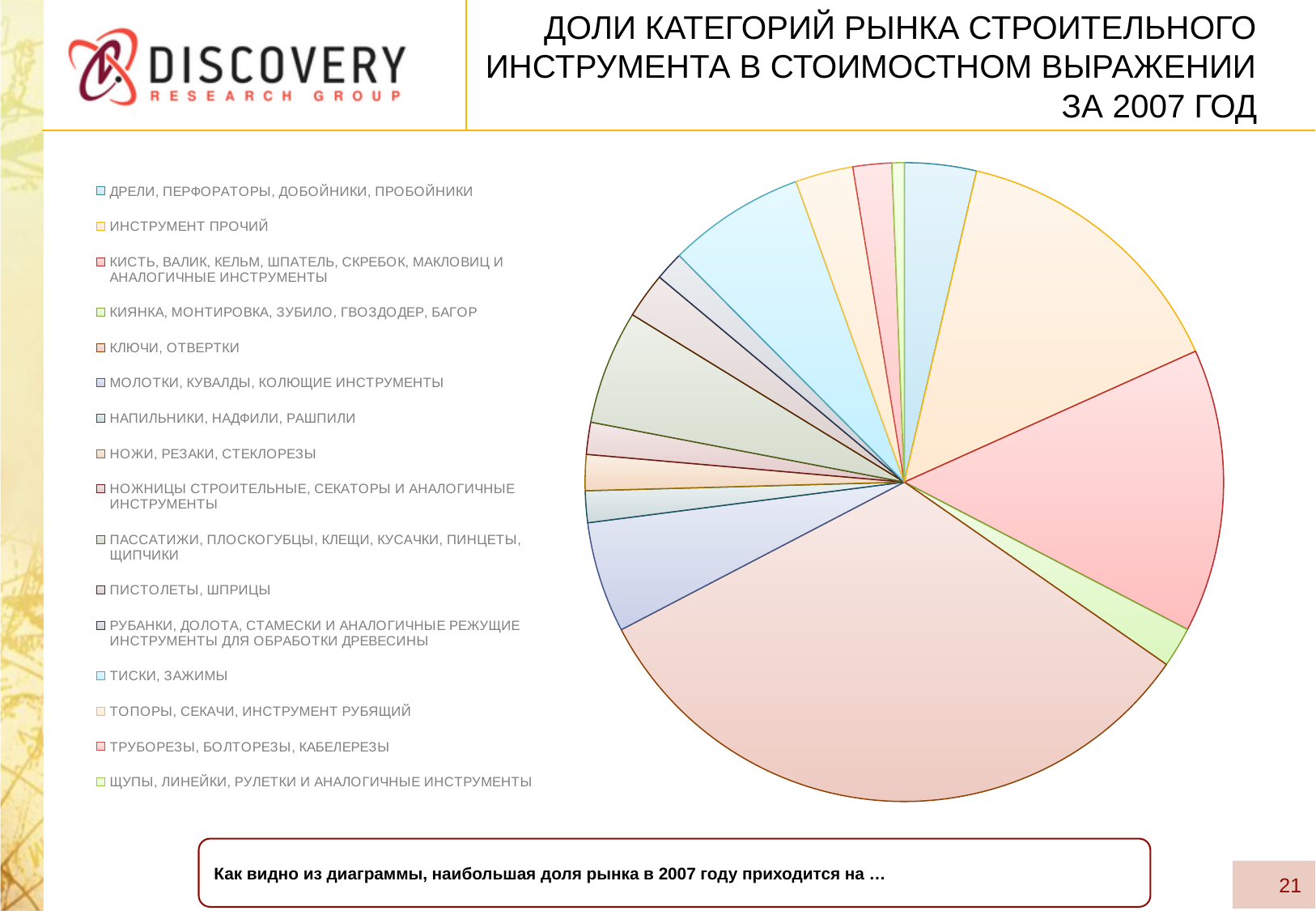
What is the title of the chart on the slide? ДОЛИ КАТЕГОРИЙ РЫНКА СТРОИТЕЛЬНОГО ИНСТРУМЕНТА В СТОИМОСТНОМ ВЫРАЖЕНИИ ЗА 2007 ГОД How many categories (slices) does the pie chart show? 16 Which slice is larger: КЛЮЧИ, ОТВЕРТКИ or МОЛОТКИ, КУВАЛДЫ, КОЛЮЩИЕ ИНСТРУМЕНТЫ? КЛЮЧИ, ОТВЕРТКИ Which category has the largest share of the pie? КЛЮЧИ, ОТВЕРТКИ Which slice is larger: КИСТЬ, ВАЛИК, КЕЛЬМ, ШПАТЕЛЬ, СКРЕБОК, МАКЛОВИЦ И АНАЛОГИЧНЫЕ ИНСТРУМЕНТЫ or КИЯНКА, МОНТИРОВКА, ЗУБИЛО, ГВОЗДОДЕР, БАГОР? КИСТЬ, ВАЛИК, КЕЛЬМ, ШПАТЕЛЬ, СКРЕБОК, МАКЛОВИЦ И АНАЛОГИЧНЫЕ ИНСТРУМЕНТЫ Which year does the pie chart's data refer to, according to the slide title? 2007 What kind of chart is shown on the slide? Pie chart Which slice is larger: КЛЮЧИ, ОТВЕРТКИ or ИНСТРУМЕНТ ПРОЧИЙ? КЛЮЧИ, ОТВЕРТКИ